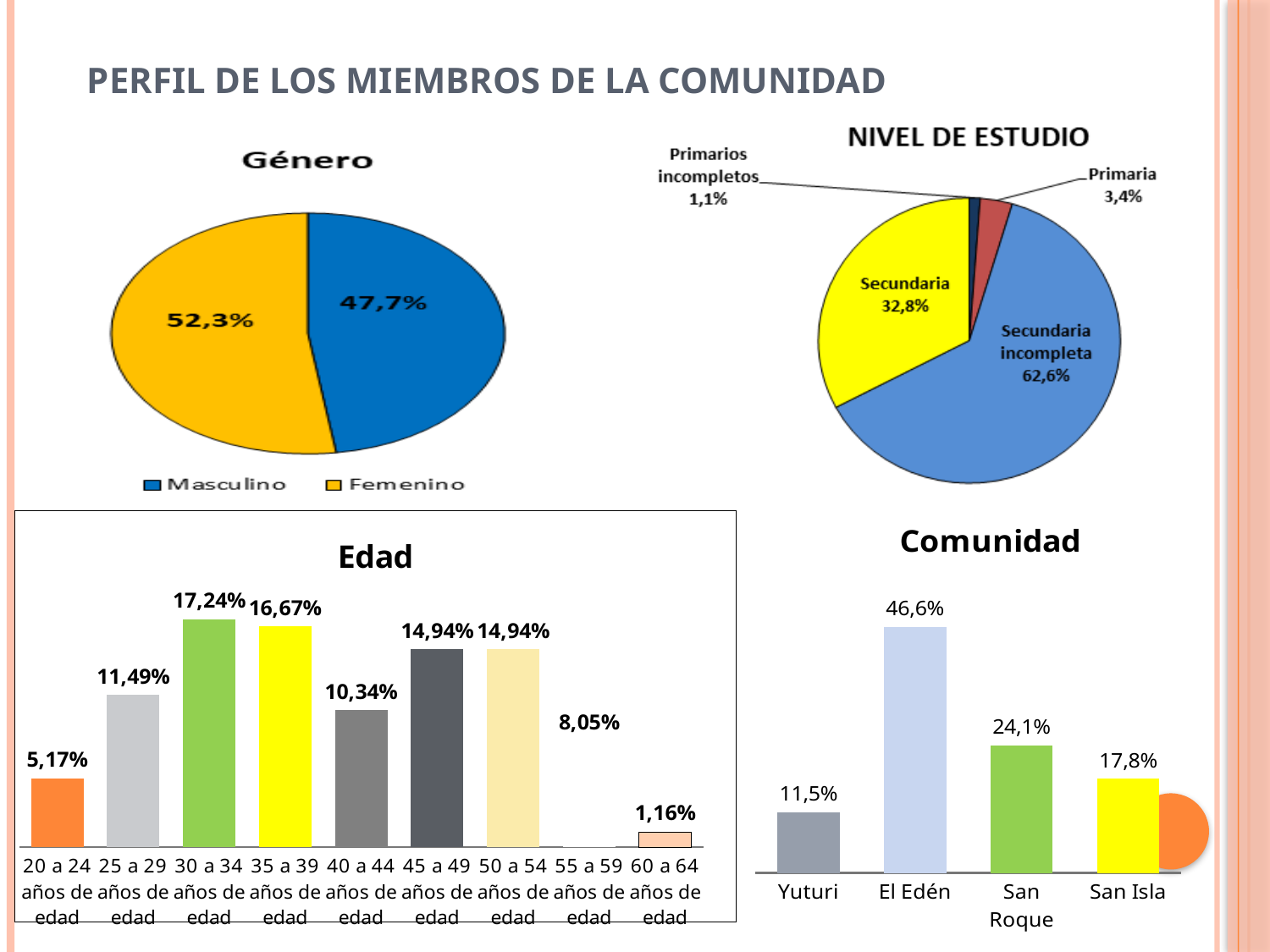
In the Edad chart, which age group has the highest value? 30 a 34 años de edad In the Comunidad chart, what is the difference between El Edén and Yuturi? 35,1% In the Edad chart, what is the difference between the values for 25 a 29 años de edad and 20 a 24 años de edad? 6,32% In the Género pie chart, what share is Femenino? 52,3% In the Nivel de Estudio pie chart, which category has the smallest share? Primarios incompletos In the Comunidad chart, what is the value for San Roque? 24,1% In the Comunidad chart, which community has the highest value? El Edén In the Nivel de Estudio pie chart, how many slices are there? 4 In the Edad chart, what kind of chart is shown? Bar chart In the Edad chart, what is the value for 30 a 34 años de edad? 17,24% In the Nivel de Estudio pie chart, what share is Secundaria incompleta? 62,6% In the Género pie chart, which slice is larger, Masculino or Femenino? Femenino